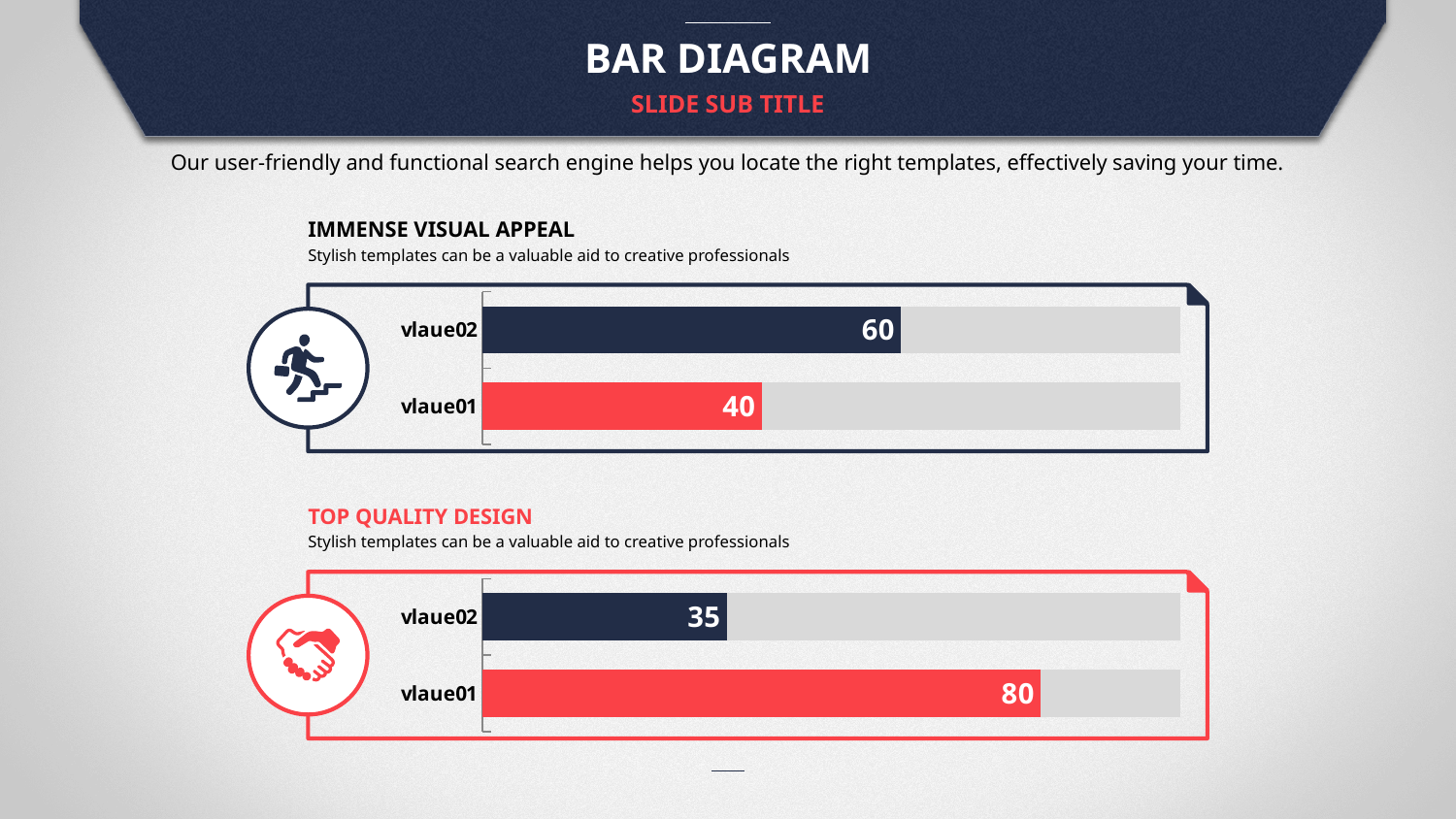
In the IMMENSE VISUAL APPEAL chart, what is the value for vlaue01? 40 In the IMMENSE VISUAL APPEAL chart, what is the difference between the values for vlaue02 and vlaue01? 20 In the IMMENSE VISUAL APPEAL chart, what colour is the bar for vlaue01? Red In the TOP QUALITY DESIGN chart, which category has the lowest value? vlaue02 What kind of chart is the TOP QUALITY DESIGN chart? Bar chart How many categories are shown in the IMMENSE VISUAL APPEAL chart? 2 In the IMMENSE VISUAL APPEAL chart, what is the value for vlaue02? 60 In the TOP QUALITY DESIGN chart, which is larger, the value for vlaue01 or vlaue02? vlaue01 In the TOP QUALITY DESIGN chart, what is the value for vlaue01? 80 In the IMMENSE VISUAL APPEAL chart, which category has the highest value? vlaue02 In the TOP QUALITY DESIGN chart, what is the value for vlaue02? 35 In the TOP QUALITY DESIGN chart, what is the difference between the values for vlaue01 and vlaue02? 45